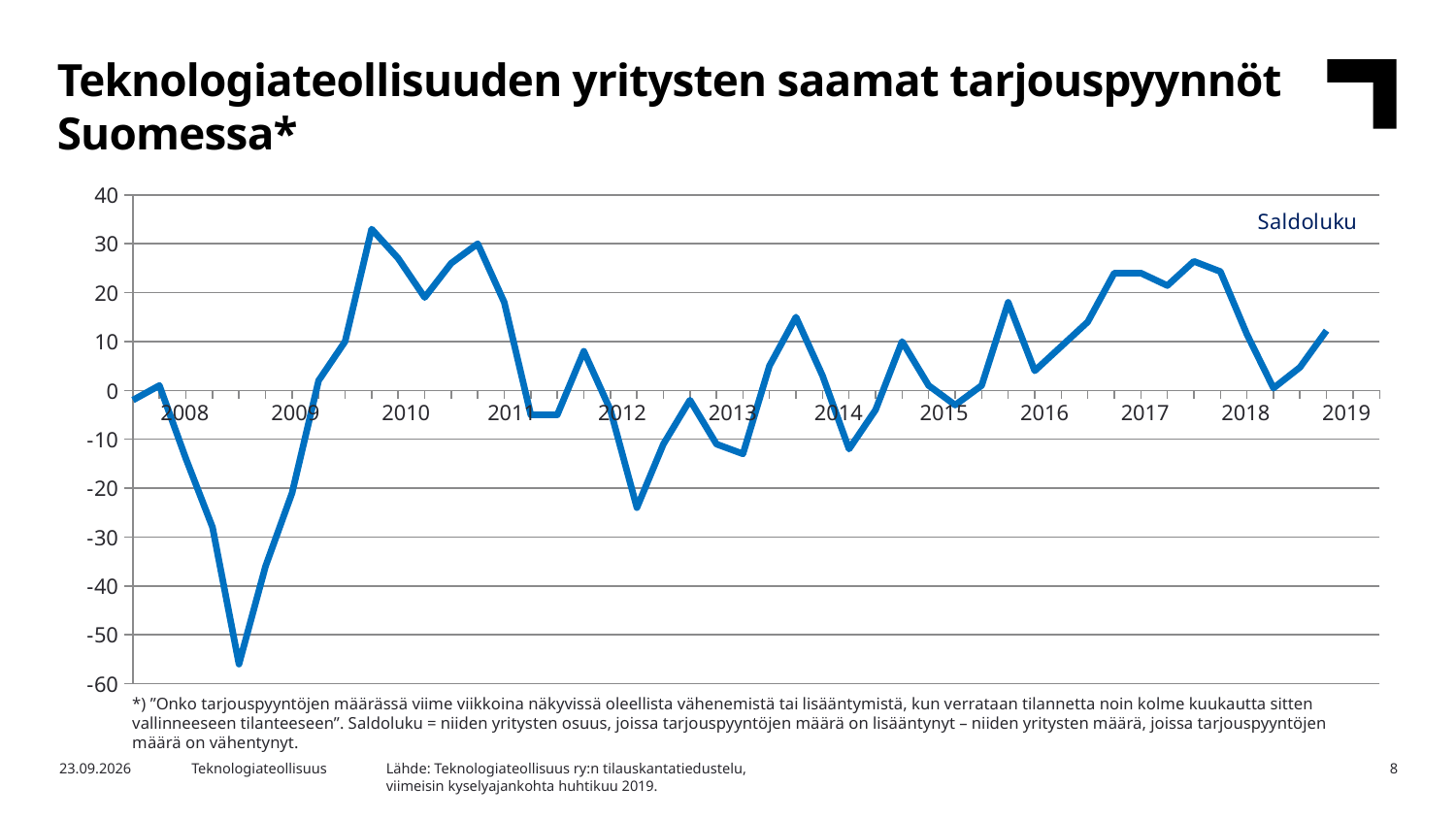
How many year labels are shown on the x axis? 12 Is the dip in the line during 2012 greater or less than -20? less Is the lowest value of the line, reached in 2009, greater or less than -50? less What is the title of the chart on the slide? Teknologiateollisuuden yritysten saamat tarjouspyynnöt Suomessa* Is the last plotted value, in 2019, greater or less than 10? greater What is the name of the series shown in the legend? Saldoluku Does the line rise or fall from the start of 2008 to the start of 2009? fall In which year does the line reach its lowest value? 2009 What kind of chart is shown on the slide? line chart How many series does the legend list? 1